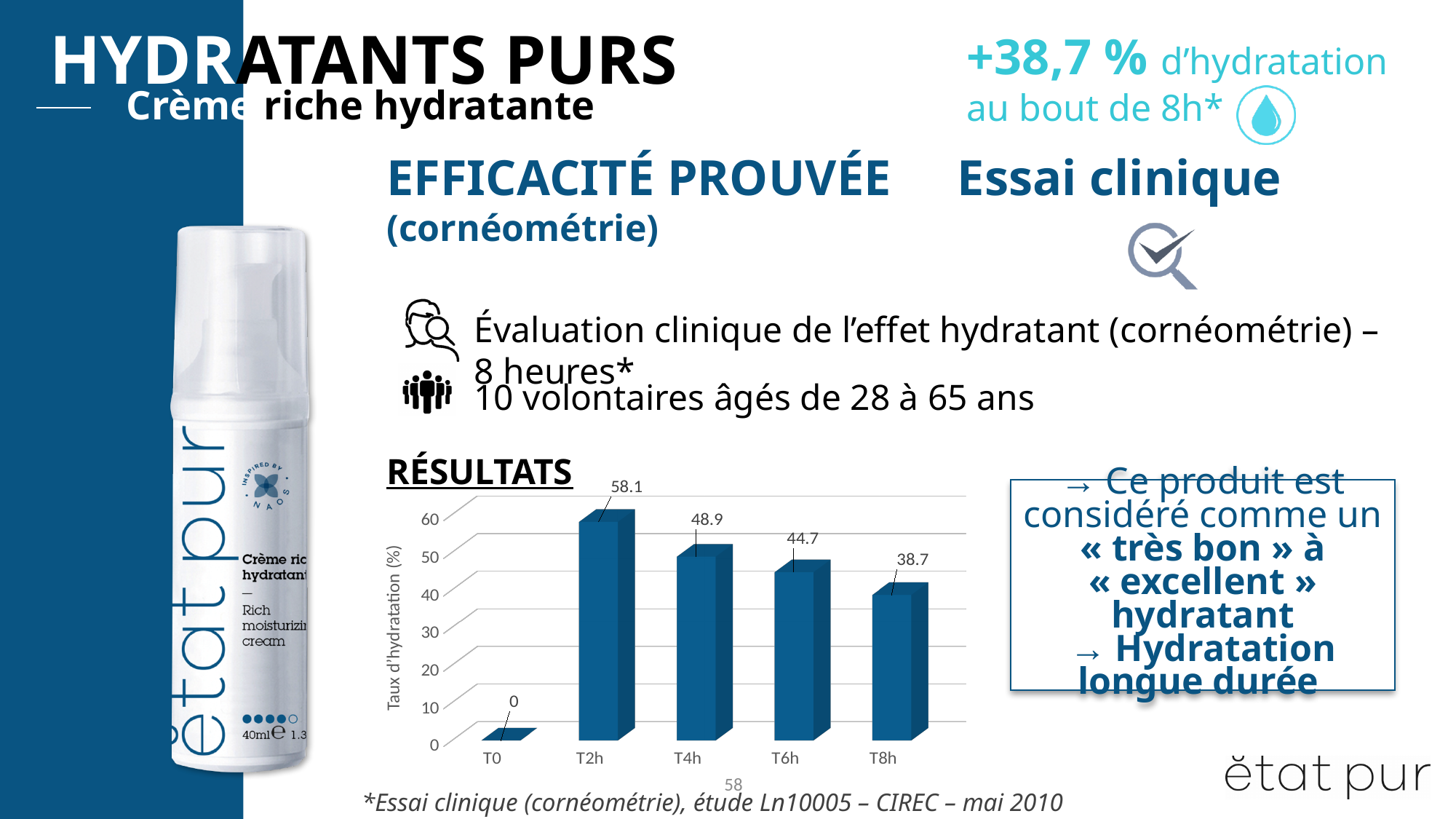
What is the label of the y axis of the chart? Taux d'hydratation (%) What kind of chart is shown in the results section? bar chart Which time point has the lowest hydration rate? T0 Is the value for T6h greater or less than 40? greater What is the hydration rate value at T0? 0 Which time point has the highest hydration rate? T2h How many time points are shown on the x axis of the chart? 5 Which has a higher hydration rate, T4h or T6h? T4h What is the hydration rate value at T2h? 58.1 What is the hydration rate value at T4h? 48.9 What is the hydration rate value at T8h? 38.7 What is the difference between the hydration rate at T2h and at T8h? 19.4